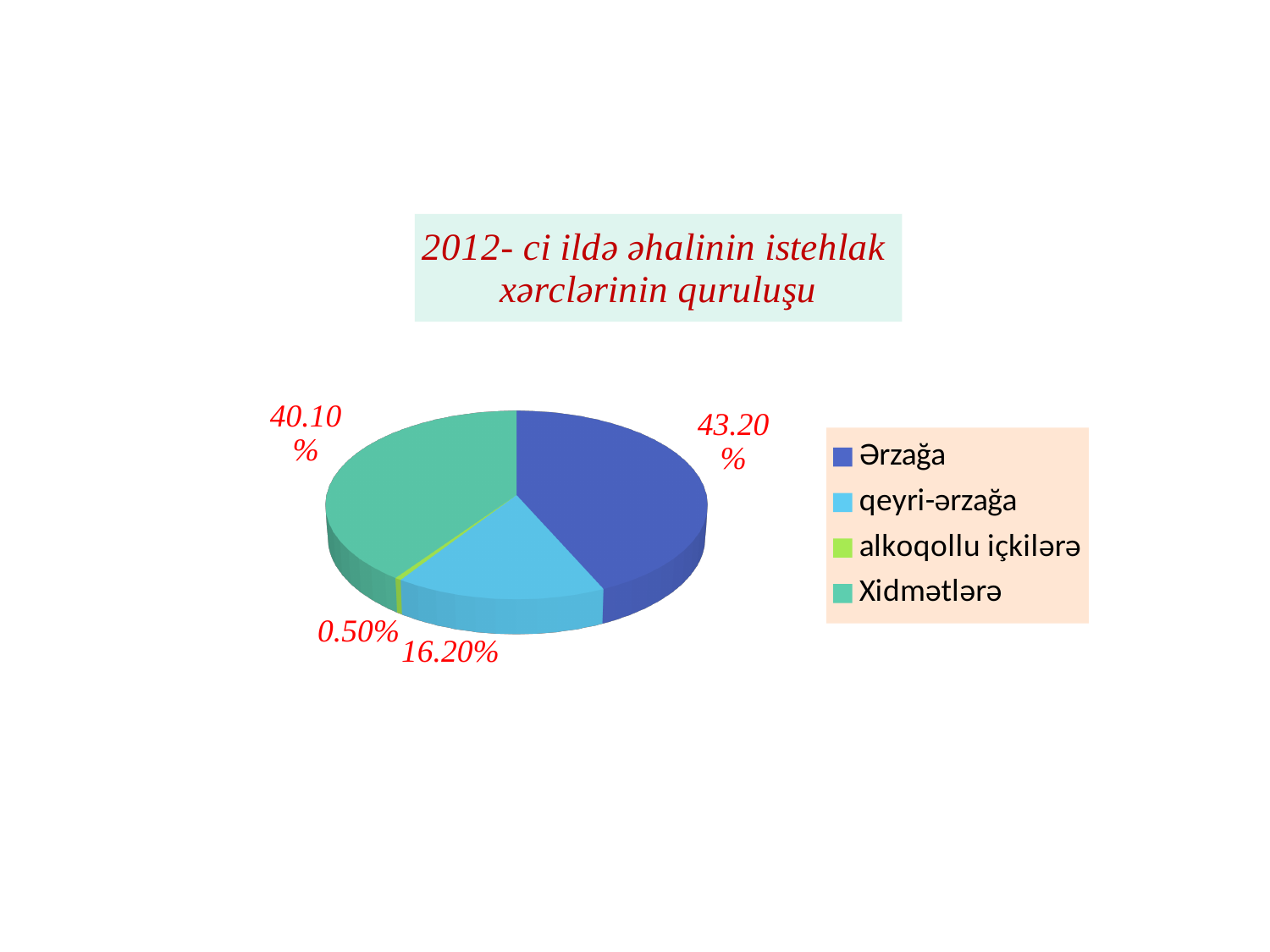
How many slices does the pie chart have? 4 What is the difference between the values for Ərzağa and Xidmətlərə? 3.10% Which category has the largest share of the pie? Ərzağa Which is larger, the value for qeyri-ərzağa or the value for Xidmətlərə? Xidmətlərə What is the value for Xidmətlərə? 40.10% What kind of chart is shown on the slide? Pie chart What is the value for qeyri-ərzağa? 16.20% Which colour represents Xidmətlərə in the legend? Green Which category has the smallest share of the pie? alkoqollu içkilərə What is the title of the chart? 2012- ci ildə əhalinin istehlak xərclərinin quruluşu What is the value for alkoqollu içkilərə? 0.50% What is the value for Ərzağa? 43.20%